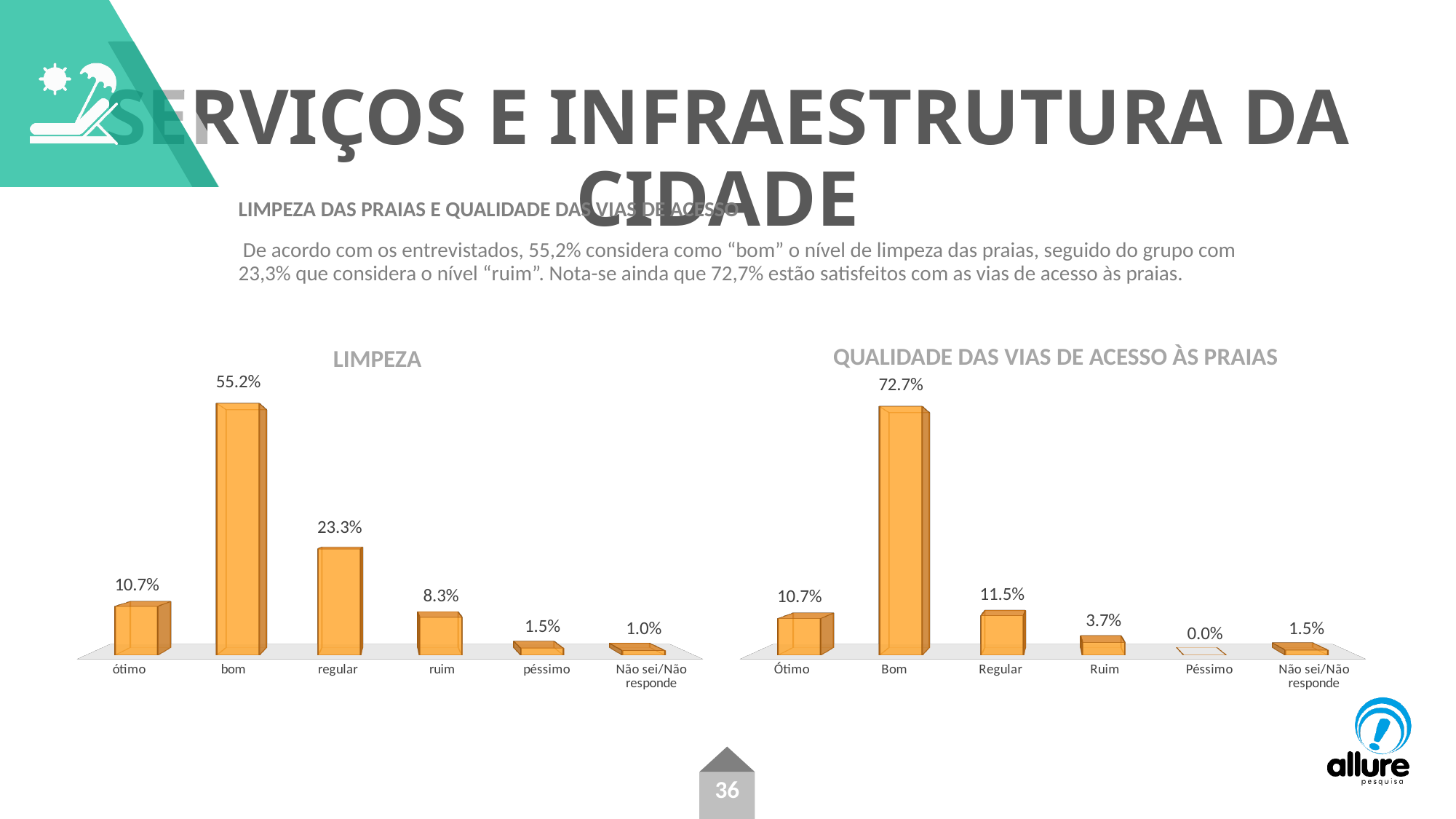
In the QUALIDADE DAS VIAS DE ACESSO ÀS PRAIAS chart, what is the value for "Péssimo"? 0.0% In the QUALIDADE DAS VIAS DE ACESSO ÀS PRAIAS chart, which category has the lowest value? Péssimo In the LIMPEZA chart, what is the value for "bom"? 55.2% In the LIMPEZA chart, what is the value for "ruim"? 8.3% In the LIMPEZA chart, what is the difference between the values for "bom" and "regular"? 31.9% In the LIMPEZA chart, which category has the highest value? bom What kind of chart is the LIMPEZA chart? Bar chart In the LIMPEZA chart, which is larger: the value for "ótimo" or the value for "ruim"? ótimo How many categories does the QUALIDADE DAS VIAS DE ACESSO ÀS PRAIAS chart show? 6 In the LIMPEZA chart, which category has the lowest value? Não sei/Não responde In the QUALIDADE DAS VIAS DE ACESSO ÀS PRAIAS chart, what is the value for "Regular"? 11.5% In the QUALIDADE DAS VIAS DE ACESSO ÀS PRAIAS chart, what is the difference between the values for "Bom" and "Ótimo"? 62.0%